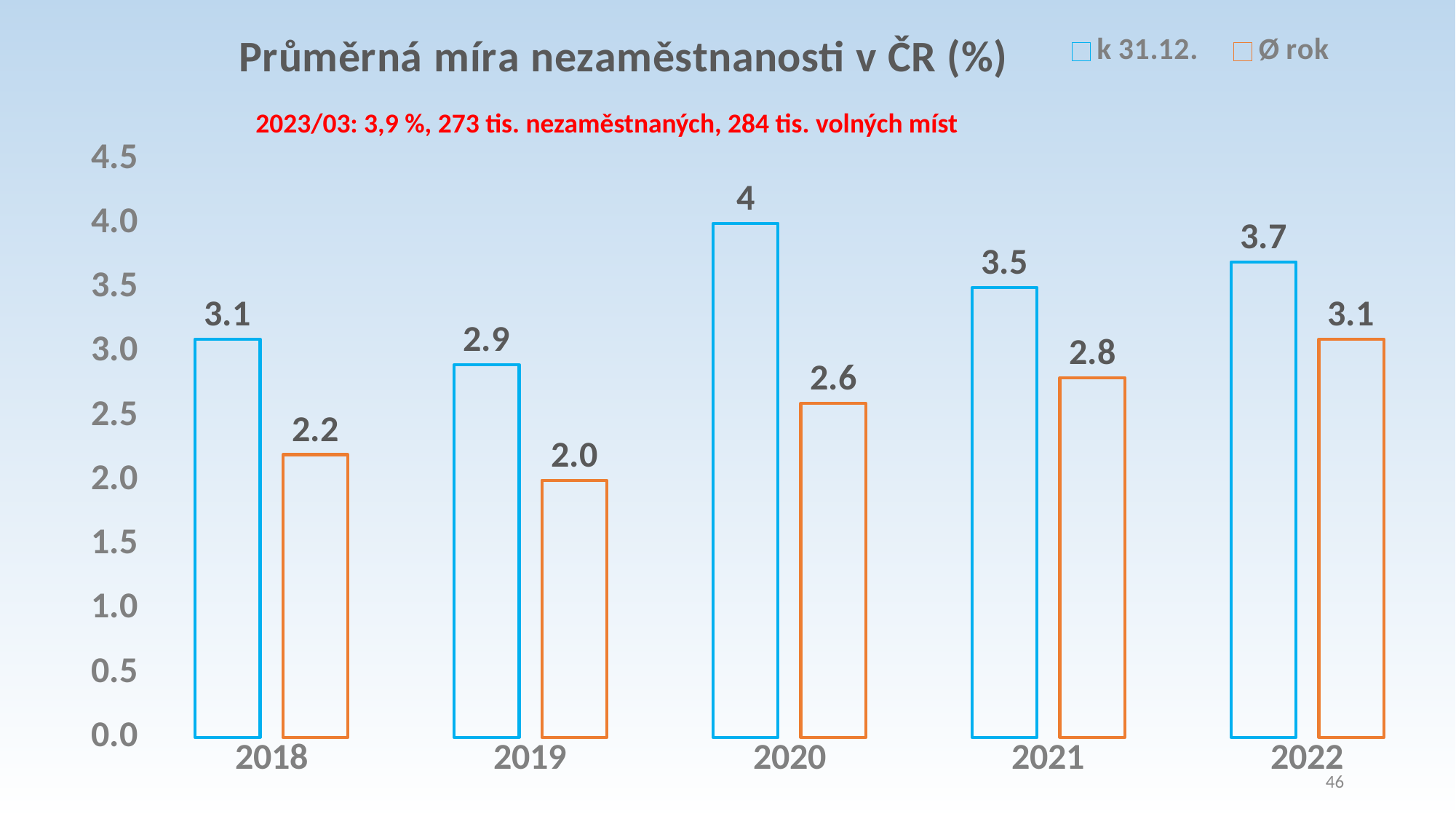
Which year has the lowest 'Ø rok' value? 2019 What is the difference between the 'k 31.12.' and 'Ø rok' values in 2020? 1.4 Do the 'Ø rok' values rise or fall from 2019 to 2022? rise Which year has the highest 'k 31.12.' value? 2020 What kind of chart is shown on the slide? bar chart How many years are shown on the x axis? 5 What is the value for 'Ø rok' in 2019? 2.0 How many series does the legend list? 2 Which is larger: the 'Ø rok' value in 2021 or the 'Ø rok' value in 2018? 2021 What is the value for 'Ø rok' in 2022? 3.1 What is the value for 'k 31.12.' in 2020? 4 What is the title of the chart? Průměrná míra nezaměstnanosti v ČR (%)